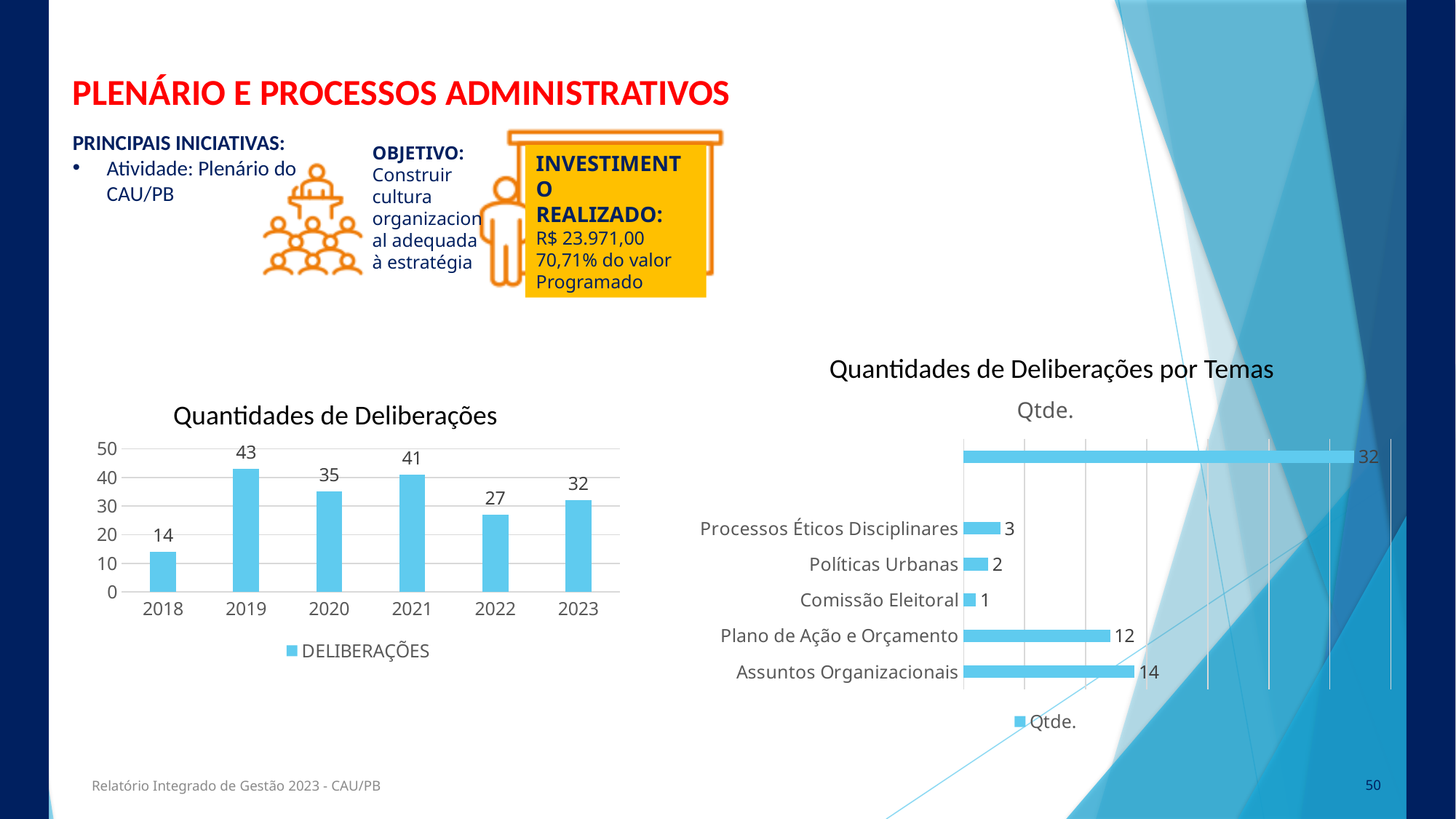
How many years are shown in the 'Quantidades de Deliberações' chart? 6 In the 'Quantidades de Deliberações por Temas' chart, what is the value for Plano de Ação e Orçamento? 12 In the 'Quantidades de Deliberações por Temas' chart, which is larger, Assuntos Organizacionais or Processos Éticos Disciplinares? Assuntos Organizacionais What type of chart is 'Quantidades de Deliberações'? Bar chart In the 'Quantidades de Deliberações' chart, what is the value for 2023? 32 What is the legend entry in the 'Quantidades de Deliberações por Temas' chart? Qtde. In the 'Quantidades de Deliberações' chart, which is larger, the value for 2020 or the value for 2023? 2020 In the 'Quantidades de Deliberações por Temas' chart, what is the value for Comissão Eleitoral? 1 In the 'Quantidades de Deliberações' chart, what is the difference between the values for 2021 and 2022? 14 In the 'Quantidades de Deliberações' chart, what is the value for 2019? 43 In the 'Quantidades de Deliberações' chart, which year has the lowest value? 2018 In the 'Quantidades de Deliberações' chart, which year has the highest value? 2019